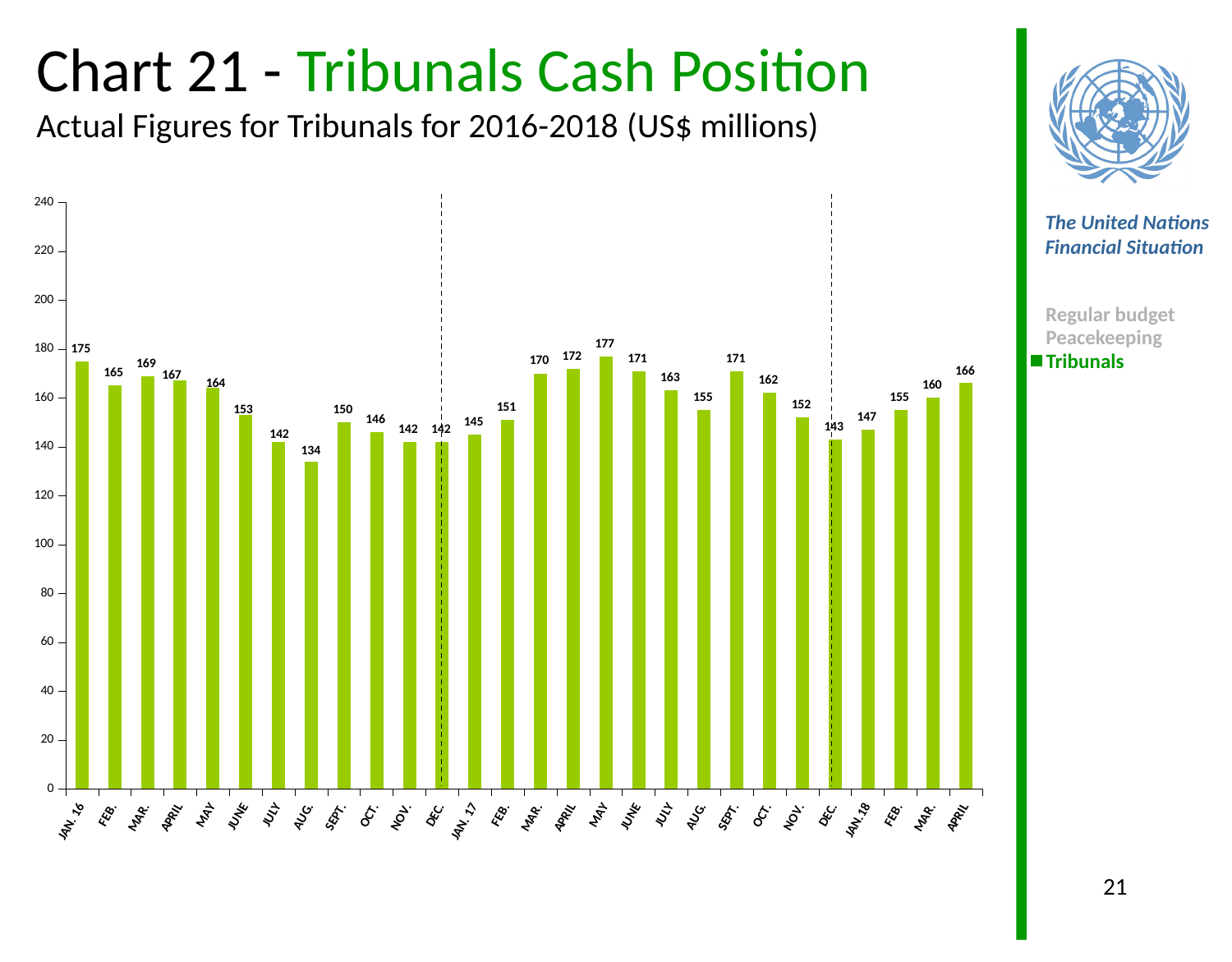
Which is larger, the value for December 2016 or the value for December 2017? December 2017 How much higher is the value for January 2016 than the value for January 2018? 28 Which month has the highest cash position on the chart? May 2017 How many monthly bars are plotted on the chart? 28 What value is shown for May 2017? 177 What unit is stated in the chart subtitle? US$ millions What is the value for April 2018, the last bar on the chart? 166 What is the difference between the highest value (May 2017) and the lowest value (August 2016)? 43 What type of chart is shown on the slide? Bar chart Do the values rise or fall from January 2016 to August 2016? Fall Which month has the lowest cash position on the chart? August 2016 What is the Tribunals cash position for January 2016? 175